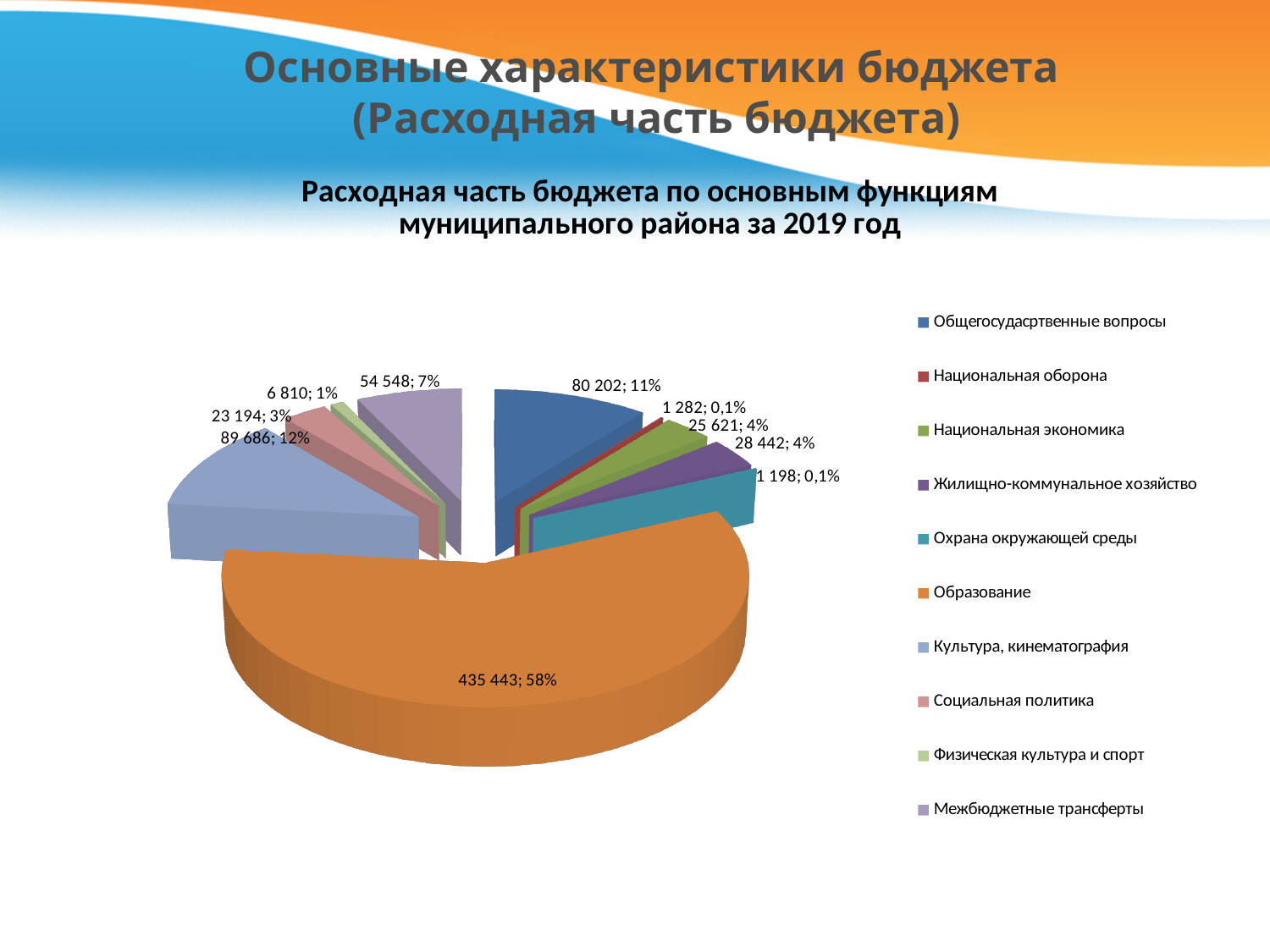
Which category has the largest slice of the pie? Образование What share of the pie does Социальная политика represent? 3% What is the difference between the values for Культура, кинематография and Общегосударственные вопросы? 9 484 What share of the pie does Образование represent? 58% How many categories does the legend of the pie chart list? 10 What kind of chart is shown on the slide? pie chart What is the title of the chart on the slide? Расходная часть бюджета по основным функциям муниципального района за 2019 год What value is shown for Образование in the pie chart? 435 443 What value is shown for Общегосударственные вопросы? 80 202 Which is larger, the value for Национальная экономика or the value for Жилищно-коммунальное хозяйство? Жилищно-коммунальное хозяйство What share of the pie does Культура, кинематография represent? 12% What value is shown for Межбюджетные трансферты? 54 548